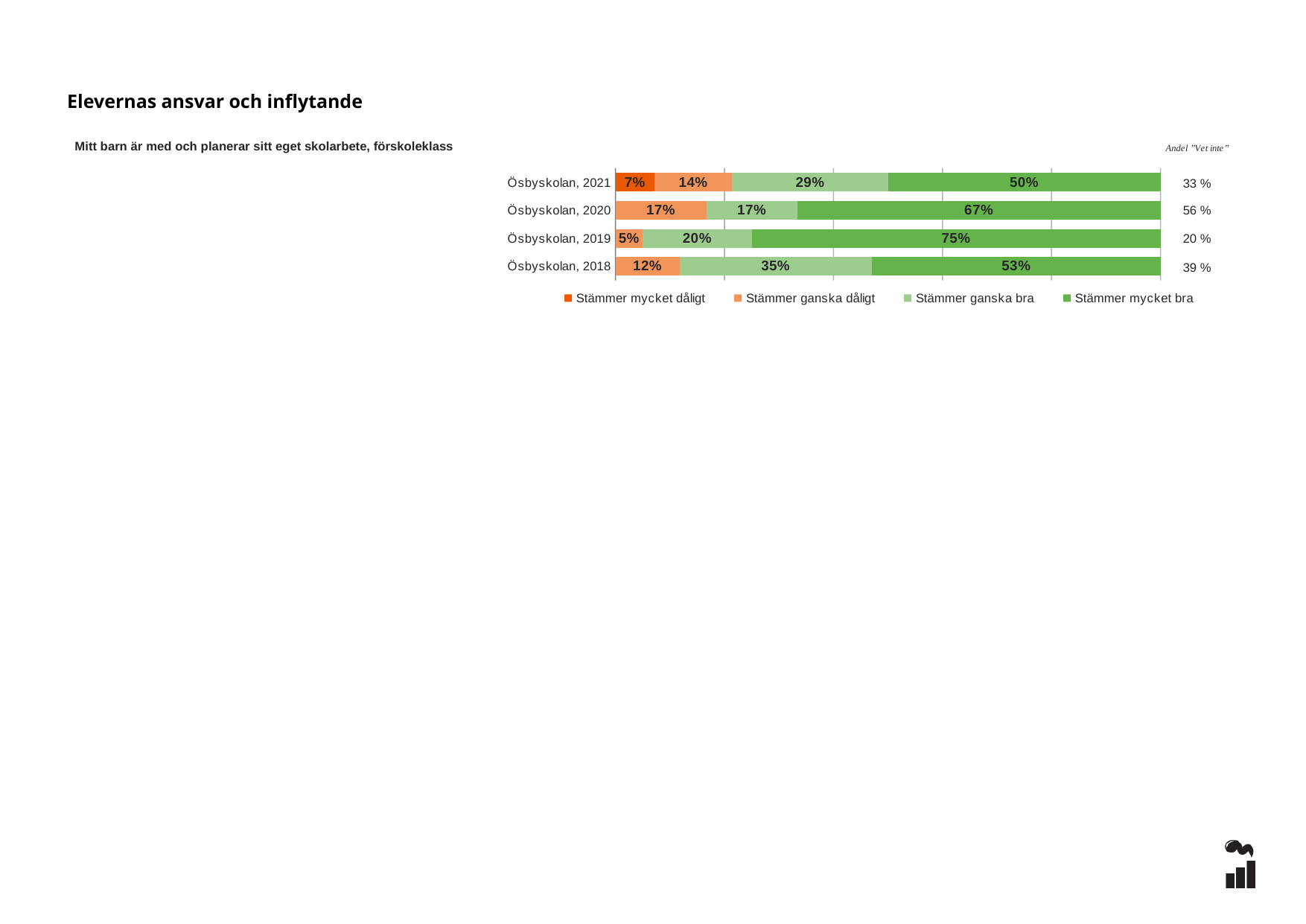
What is the value of "Stämmer ganska bra" for Ösbyskolan, 2018? 35% Which category has the lowest value for "Stämmer mycket bra"? Ösbyskolan, 2021 What is the value of "Stämmer ganska dåligt" for Ösbyskolan, 2020? 17% What is the difference between the "Stämmer mycket bra" values for Ösbyskolan, 2020 and Ösbyskolan, 2021? 17 percentage points Which category has the highest value for "Stämmer mycket bra"? Ösbyskolan, 2019 How many series does the legend list? 4 What is the "Andel Vet inte" value shown for Ösbyskolan, 2020? 56 % How many categories (bars) are shown in the chart? 4 What kind of chart is shown on the slide? Stacked bar chart What is the value of "Stämmer mycket bra" for Ösbyskolan, 2019? 75% Which is larger: "Stämmer ganska bra" for Ösbyskolan, 2018 or for Ösbyskolan, 2021? Ösbyskolan, 2018 What is the value of "Stämmer mycket dåligt" for Ösbyskolan, 2021? 7%